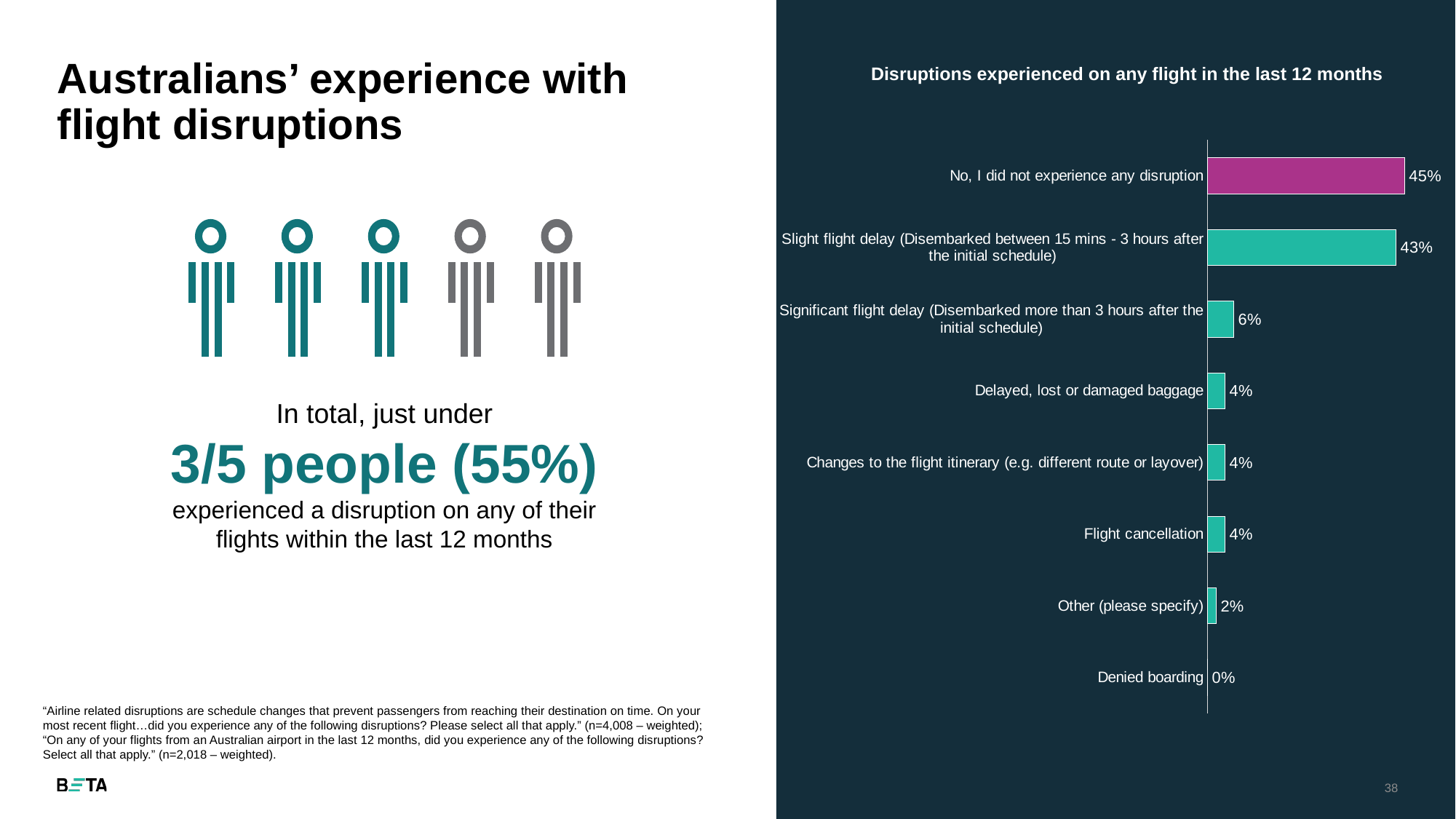
Which is larger: the value for 'Significant flight delay' or the value for 'Delayed, lost or damaged baggage'? Significant flight delay How many categories are shown in the chart? 8 What percentage of respondents reported a slight flight delay (disembarked between 15 mins - 3 hours after the initial schedule)? 43% What kind of chart is shown on the slide? Bar chart What is the value for 'Significant flight delay (Disembarked more than 3 hours after the initial schedule)'? 6% Which category has the lowest value in the chart? Denied boarding What is the title of the chart? Disruptions experienced on any flight in the last 12 months What is the difference between 'Significant flight delay' and 'Flight cancellation'? 2% What is the difference between 'No, I did not experience any disruption' and 'Slight flight delay'? 2% Which category has the highest value in the chart? No, I did not experience any disruption What is the value for 'Other (please specify)'? 2% What percentage of respondents reported 'Denied boarding'? 0%